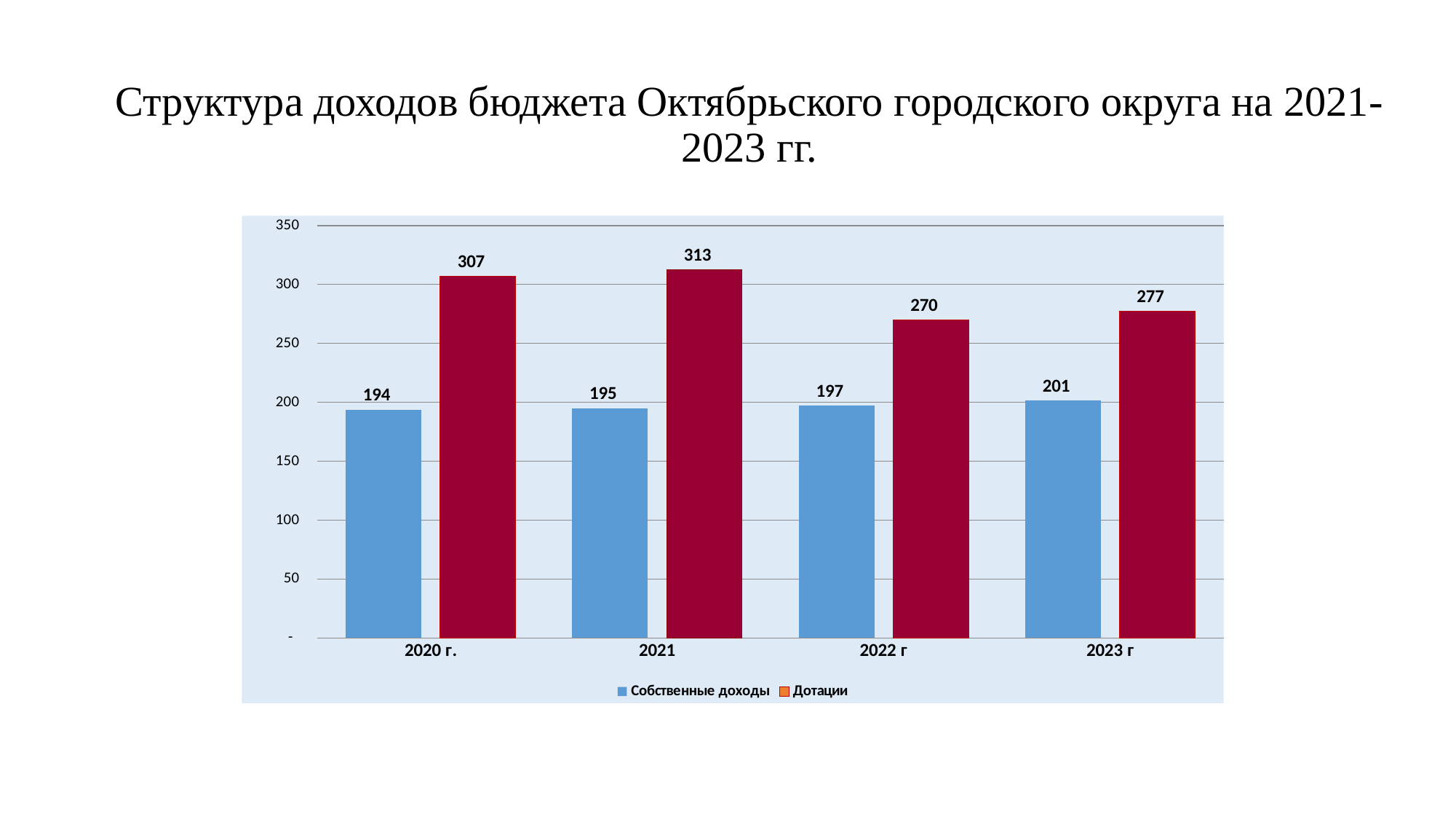
What is the value of Дотации for 2021? 313 In which year is Дотации lowest? 2022 г What is the value of Собственные доходы for 2020 г.? 194 How many series does the legend list? 2 What kind of chart is shown on the slide? Bar chart In which year is Дотации highest? 2021 Does Собственные доходы rise or fall from 2020 г. to 2023 г? Rise What is the difference between Дотации and Собственные доходы in 2023 г? 76 How many years are shown on the x axis? 4 What is the value of Дотации for 2022 г? 270 Which is larger in 2020 г.: Собственные доходы or Дотации? Дотации What is the value of Собственные доходы for 2023 г? 201